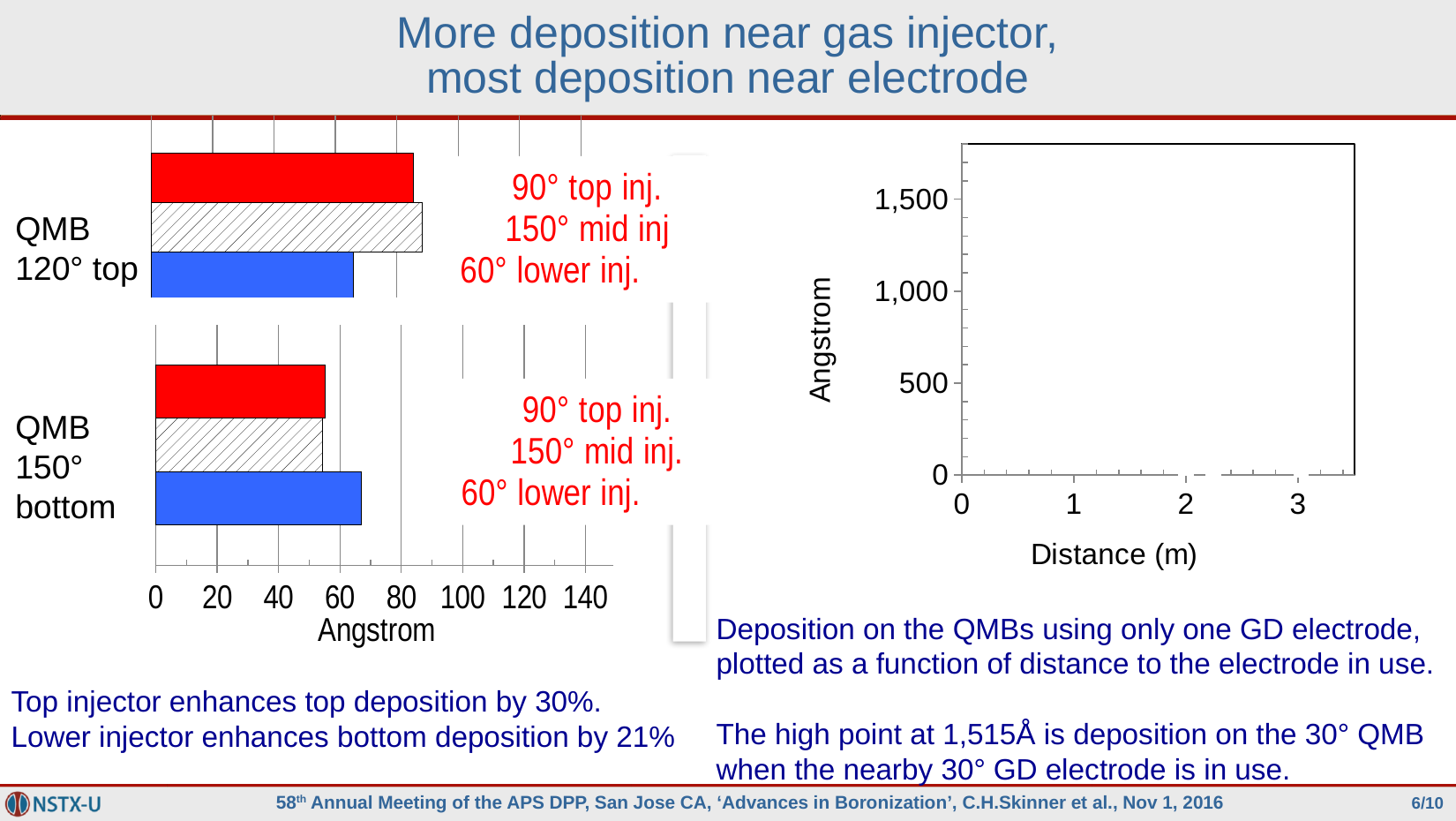
What is the x-axis label of the left-hand bar chart? Angstrom In the left-hand bar chart, for QMB 120° top, which injector gives the lowest deposition? 60° lower inj. In the left-hand bar chart, for QMB 120° top, is deposition larger with the 90° top injector or the 60° lower injector? 90° top inj. What kind of chart is the left-hand chart showing deposition on the QMBs? bar chart In the left-hand bar chart, how many injector series are shown for each QMB? 3 In the left-hand bar chart, is the value for QMB 120° top with the 90° top injector greater or less than 80 Angstrom? greater In the left-hand bar chart, is the value for QMB 150° bottom with the 60° lower injector greater or less than 60 Angstrom? greater In the left-hand bar chart, for QMB 150° bottom, which injector gives the highest deposition? 60° lower inj. In the left-hand bar chart, how many QMB categories are shown? 2 In the left-hand bar chart, is the value for QMB 150° bottom with the 90° top injector greater or less than 60 Angstrom? less What is the x-axis label of the right-hand chart? Distance (m)